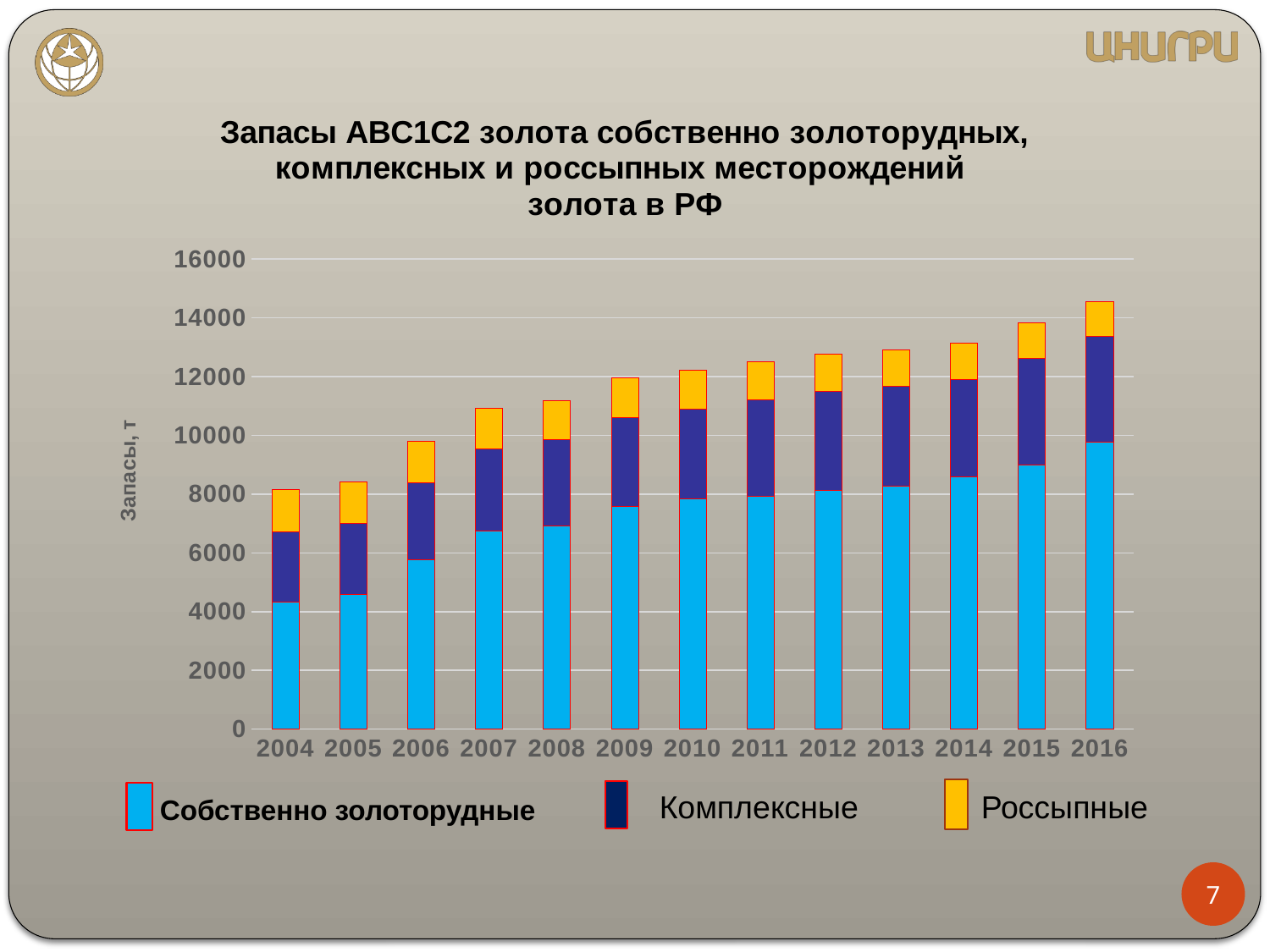
How many years are shown along the x axis of the chart? 13 What kind of chart is shown on the slide? Stacked bar chart Do the total reserves rise or fall from 2004 to 2016? Rise Which year has the lowest total bar? 2004 Which series is shown in yellow in the legend? Россыпные Which year has the highest total bar? 2016 How many series does the legend list? 3 What is the label on the vertical axis of the chart? Запасы, т Is the value for Собственно золоторудные in 2016 greater or less than 10000? less Is the total bar for 2006 greater or less than 10000? less Is the value for Собственно золоторудные in 2014 greater or less than 8000? greater